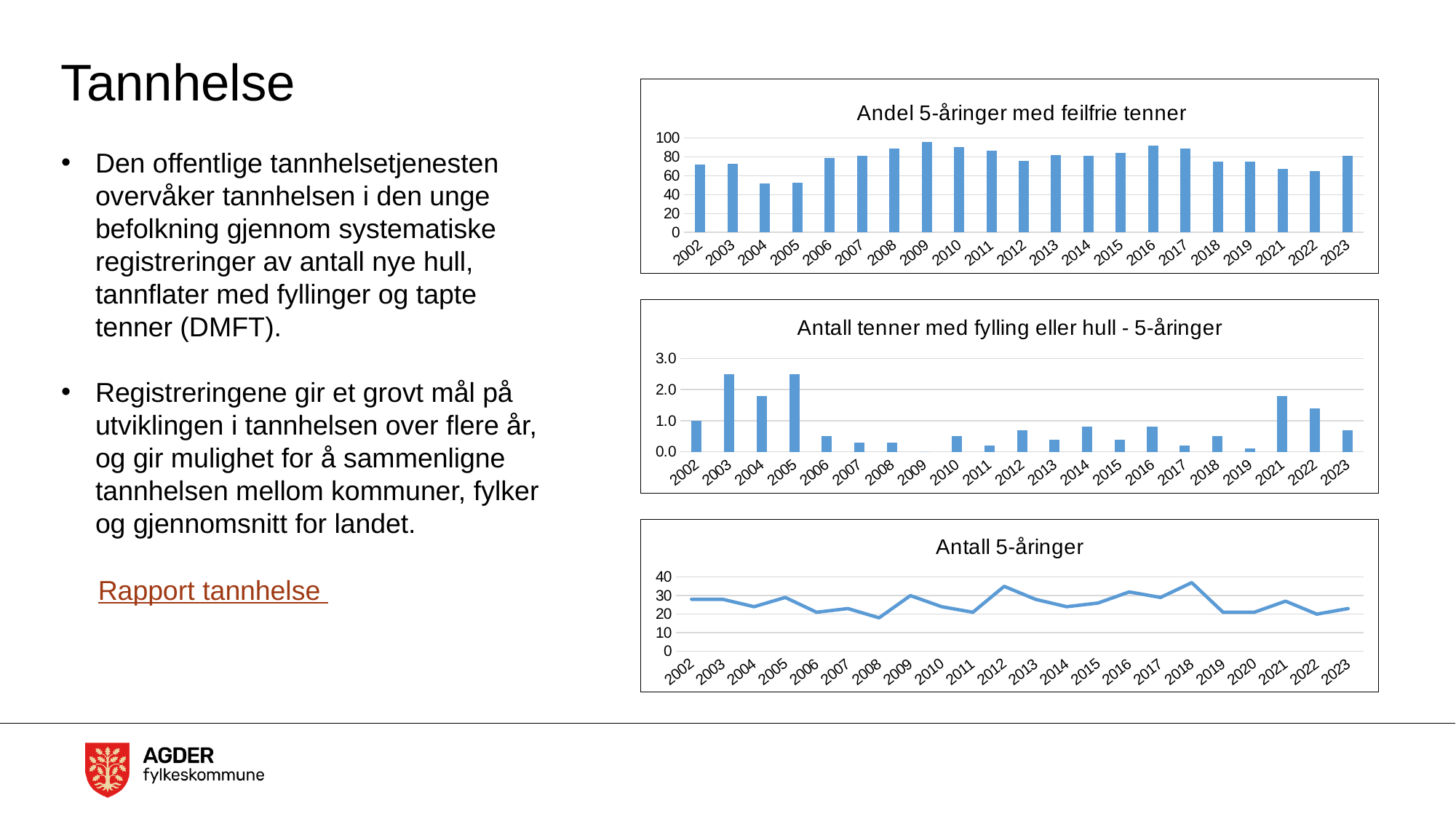
In the chart 'Andel 5-åringer med feilfrie tenner', is the value for 2016 greater or less than 80? greater In the chart 'Andel 5-åringer med feilfrie tenner', is the value for 2004 greater or less than 60? less What type of chart is 'Antall 5-åringer'? line chart In the chart 'Antall tenner med fylling eller hull - 5-åringer', which is larger, the value for 2004 or the value for 2006? 2004 What type of chart is 'Andel 5-åringer med feilfrie tenner'? bar chart How many years are shown on the x axis of the chart 'Andel 5-åringer med feilfrie tenner'? 21 In the chart 'Andel 5-åringer med feilfrie tenner', which year has the highest value? 2009 In the chart 'Antall tenner med fylling eller hull - 5-åringer', is the value for 2003 greater or less than 2.0? greater In the chart 'Andel 5-åringer med feilfrie tenner', which is larger, the value for 2009 or the value for 2022? 2009 In the chart 'Antall tenner med fylling eller hull - 5-åringer', which year has the lowest value? 2009 How many years are shown on the x axis of the chart 'Antall 5-åringer'? 22